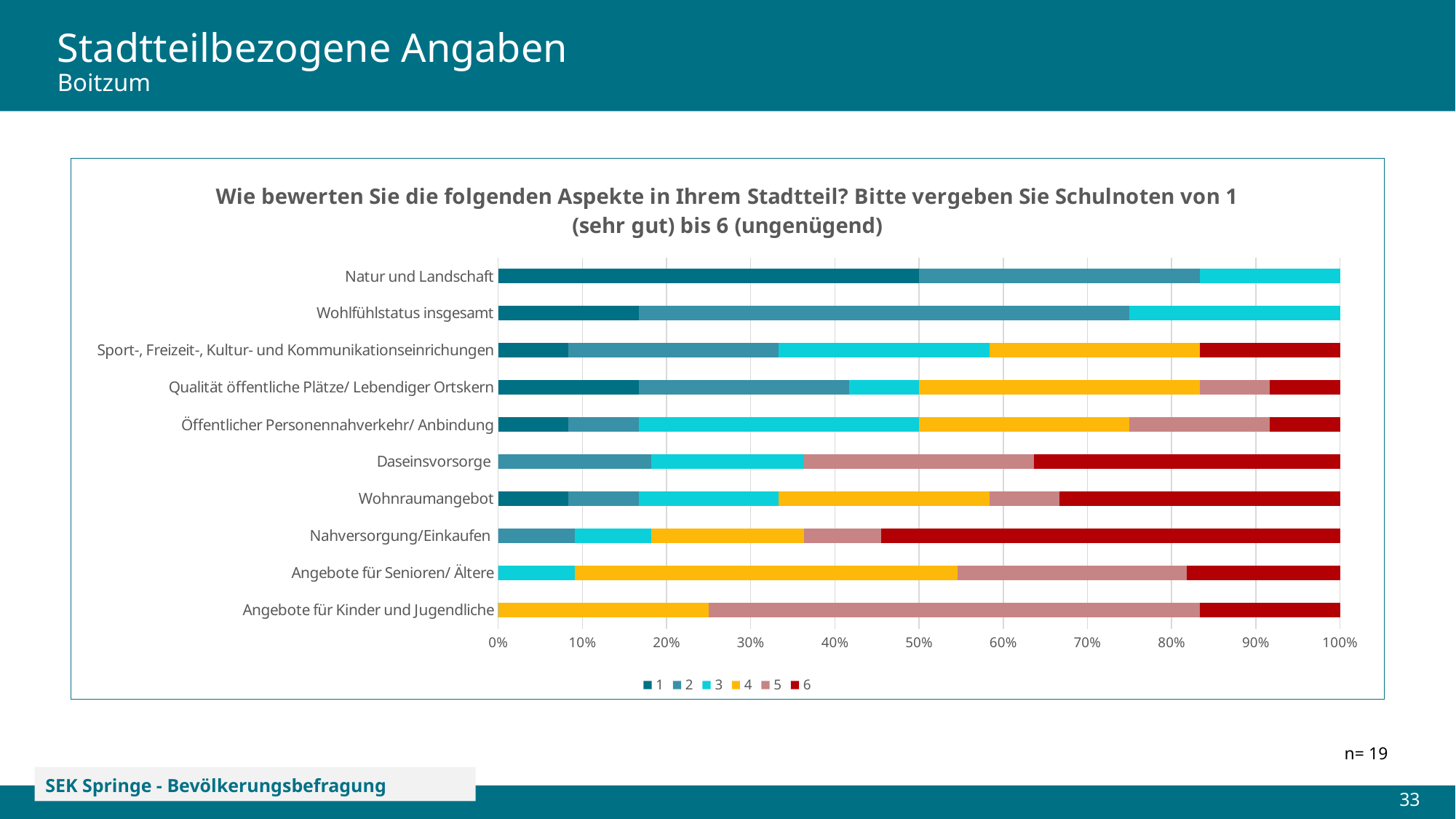
Which category has the largest share of grade 6 (dark red segment)? Nahversorgung/Einkaufen What are the legend entries of the chart? 1, 2, 3, 4, 5, 6 How many series does the legend list? 6 Is the grade 4 share for Angebote für Kinder und Jugendliche greater or less than 20%? greater Which category has the largest share of grade 1 (darkest blue segment)? Natur und Landschaft Which has the larger grade 6 share: Nahversorgung/Einkaufen or Daseinsvorsorge? Nahversorgung/Einkaufen Is the grade 1 share for Natur und Landschaft greater or less than 40%? greater How many categories (aspects) are listed on the chart? 10 Which has the larger grade 1 share: Natur und Landschaft or Wohlfühlstatus insgesamt? Natur und Landschaft Is the grade 6 share for Daseinsvorsorge greater or less than 30%? greater What kind of chart is shown on the slide? bar chart